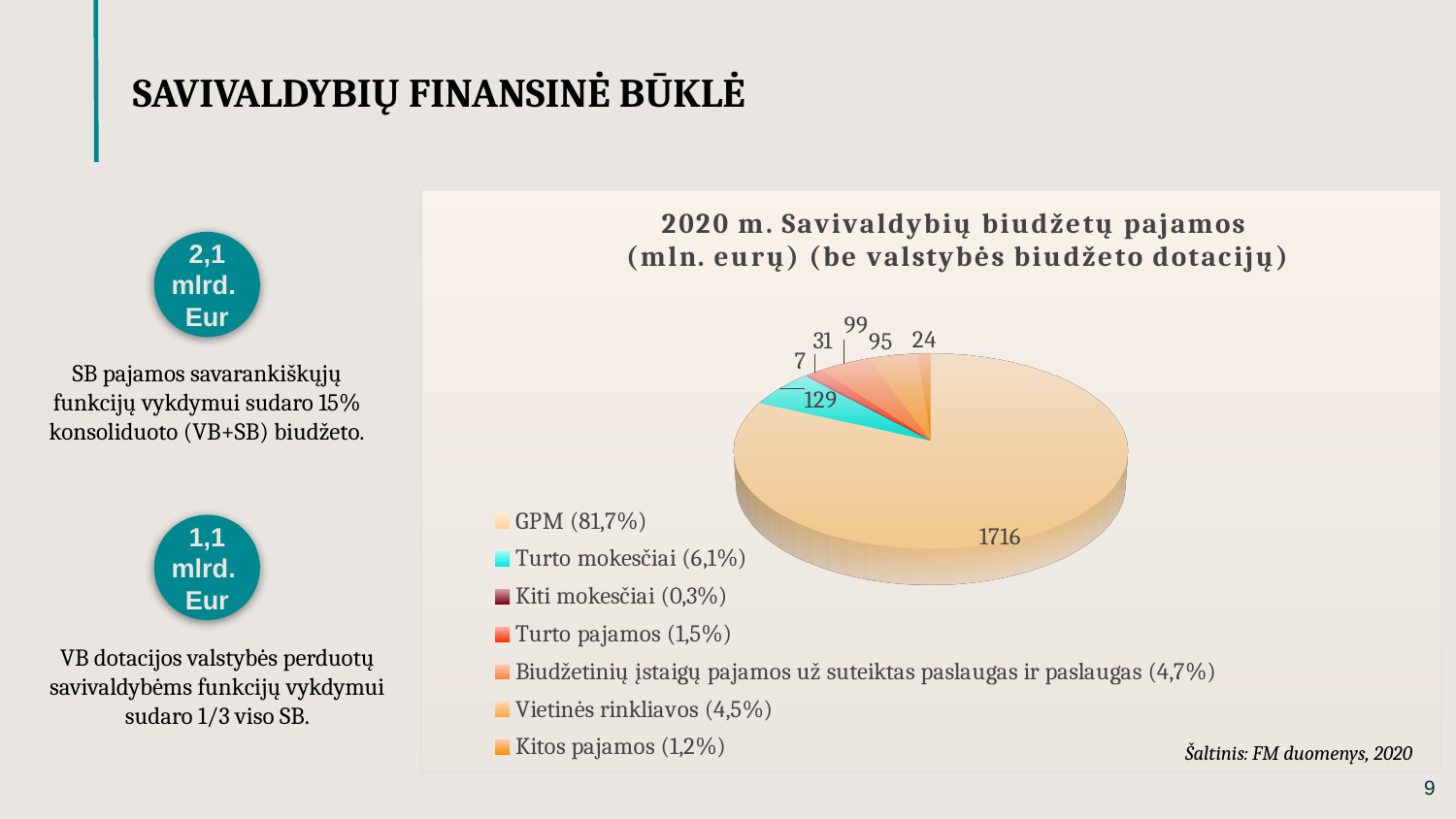
What is the difference between the GPM value and the Turto mokesčiai value? 1587 What is the value for GPM in the pie chart? 1716 What is the title of the pie chart? 2020 m. Savivaldybių biudžetų pajamos (mln. eurų) (be valstybės biudžeto dotacijų) Which category has the largest slice of the pie? GPM What is the value for Kiti mokesčiai in the pie chart? 7 How many categories does the pie chart legend list? 7 What is the value for Turto mokesčiai in the pie chart? 129 Which is larger: the value for Biudžetinių įstaigų pajamos už suteiktas paslaugas ir paslaugas or the value for Vietinės rinkliavos? Biudžetinių įstaigų pajamos už suteiktas paslaugas ir paslaugas What kind of chart is shown on the slide? pie chart Which category has the smallest slice of the pie? Kiti mokesčiai What share of the pie does Vietinės rinkliavos account for, according to the legend? 4,5% What share of the pie does GPM account for, according to the legend? 81,7%